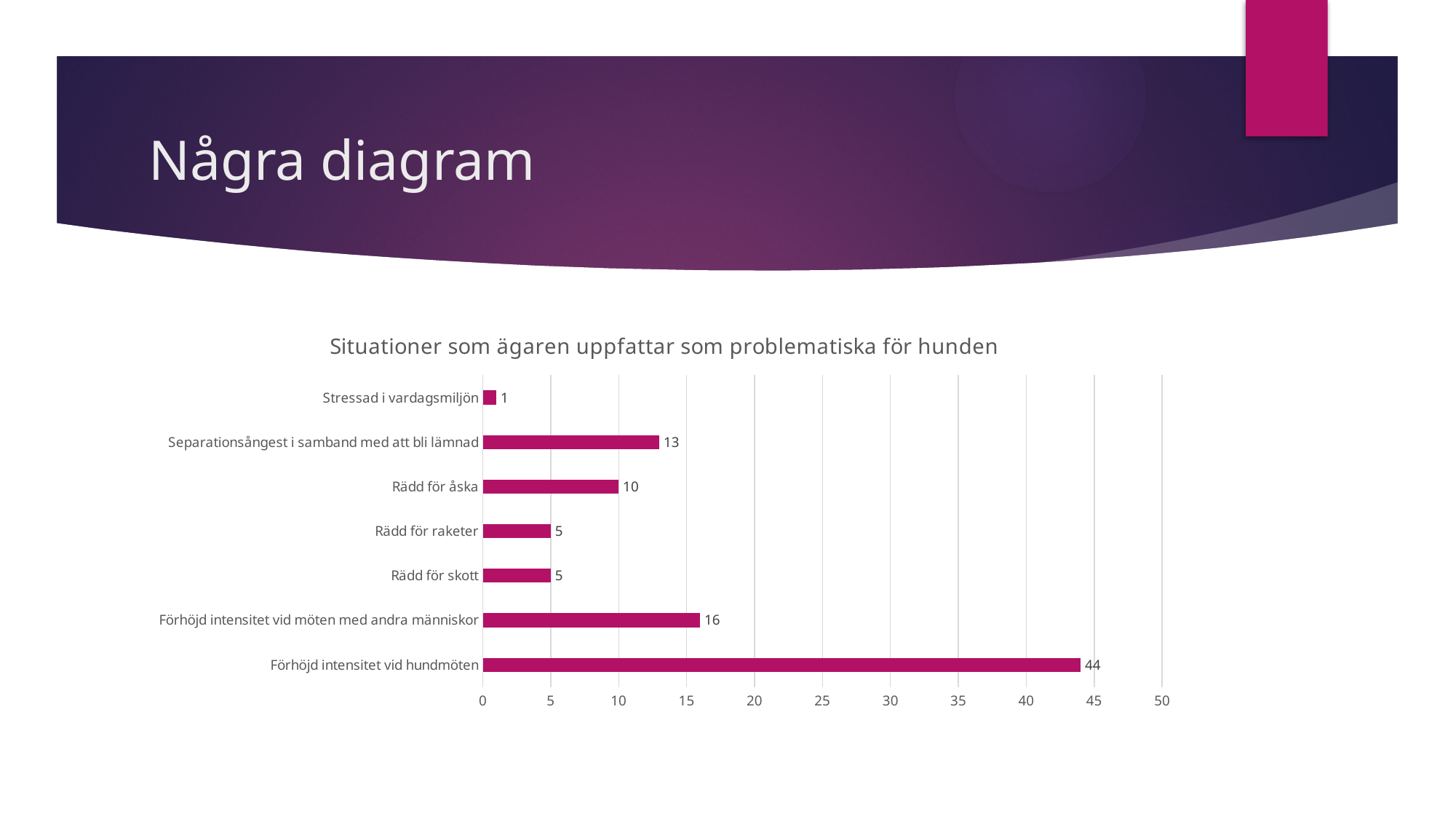
Which category has the lowest value? Stressad i vardagsmiljön What is the value for "Stressad i vardagsmiljön"? 1 Which category has the highest value? Förhöjd intensitet vid hundmöten What is the title of the chart? Situationer som ägaren uppfattar som problematiska för hunden What is the value for "Separationsångest i samband med att bli lämnad"? 13 What is the value for "Förhöjd intensitet vid hundmöten"? 44 What is the difference between the values for "Förhöjd intensitet vid hundmöten" and "Förhöjd intensitet vid möten med andra människor"? 28 What kind of chart is shown on the slide? Bar chart What is the value for "Rädd för åska"? 10 Is the value for "Förhöjd intensitet vid möten med andra människor" greater or less than 20? less Which is larger, the value for "Separationsångest i samband med att bli lämnad" or the value for "Rädd för åska"? Separationsångest i samband med att bli lämnad How many categories are shown in the chart? 7